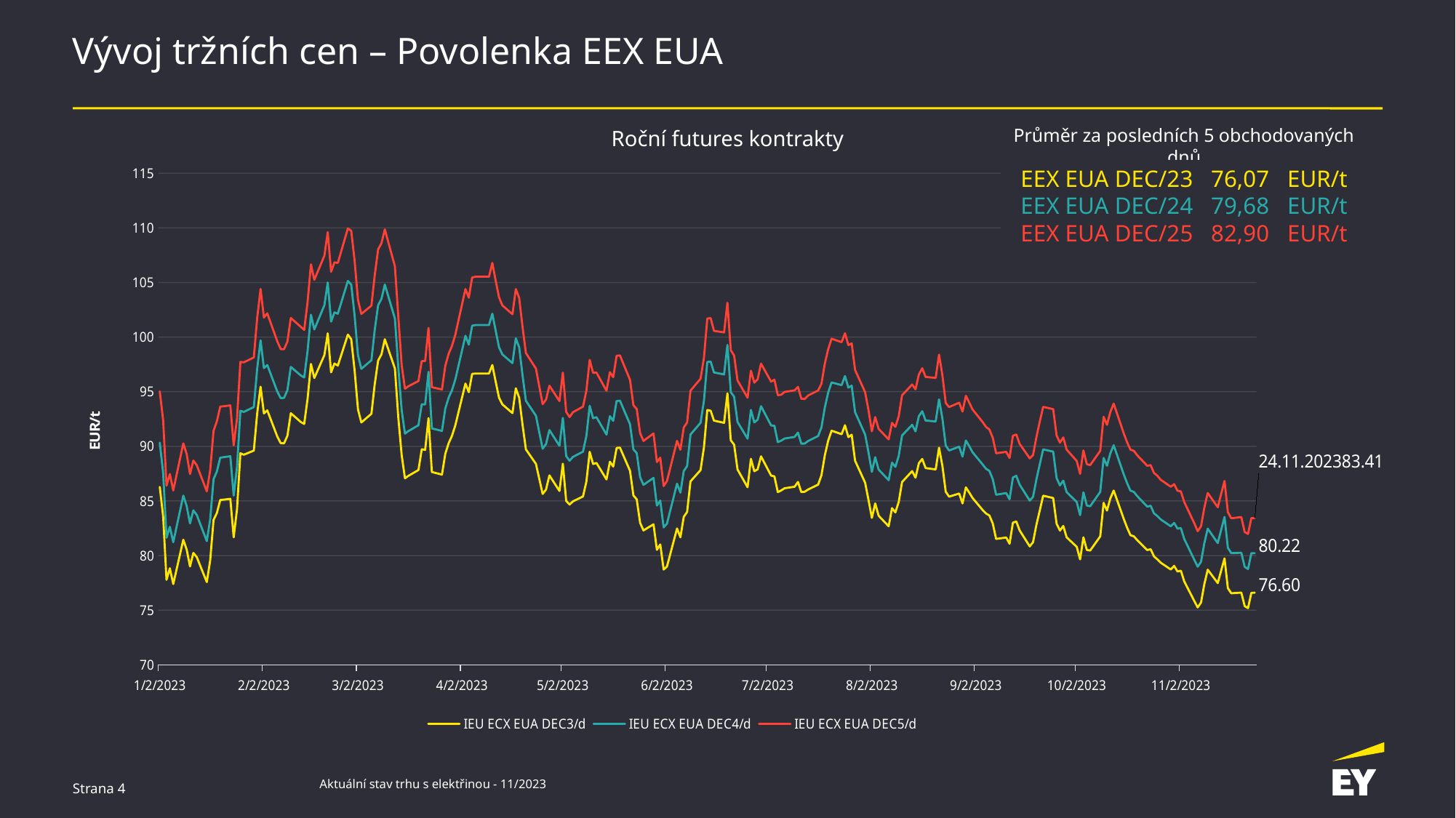
What is the label on the vertical axis of the chart? EUR/t Is the IEU ECX EUA DEC5/d value at the end of the chart higher or lower than at the start? lower What is the value of IEU ECX EUA DEC5/d on 24.11.2023 according to the data label? 83.41 Is the peak value of IEU ECX EUA DEC5/d around 3/2/2023 greater or less than 105? greater What is the final labelled value of the IEU ECX EUA DEC3/d series? 76.60 What is the difference between the final labelled values of IEU ECX EUA DEC5/d and IEU ECX EUA DEC3/d? 6.81 What is the difference between the final labelled values of IEU ECX EUA DEC5/d and IEU ECX EUA DEC4/d? 3.19 Which series has the highest value at the end of the chart (24.11.2023)? IEU ECX EUA DEC5/d What is the final labelled value of the IEU ECX EUA DEC4/d series? 80.22 Is the value of IEU ECX EUA DEC3/d at 1/2/2023 greater or less than 90? less What type of chart is shown on the slide? line chart How many series does the chart legend list? 3